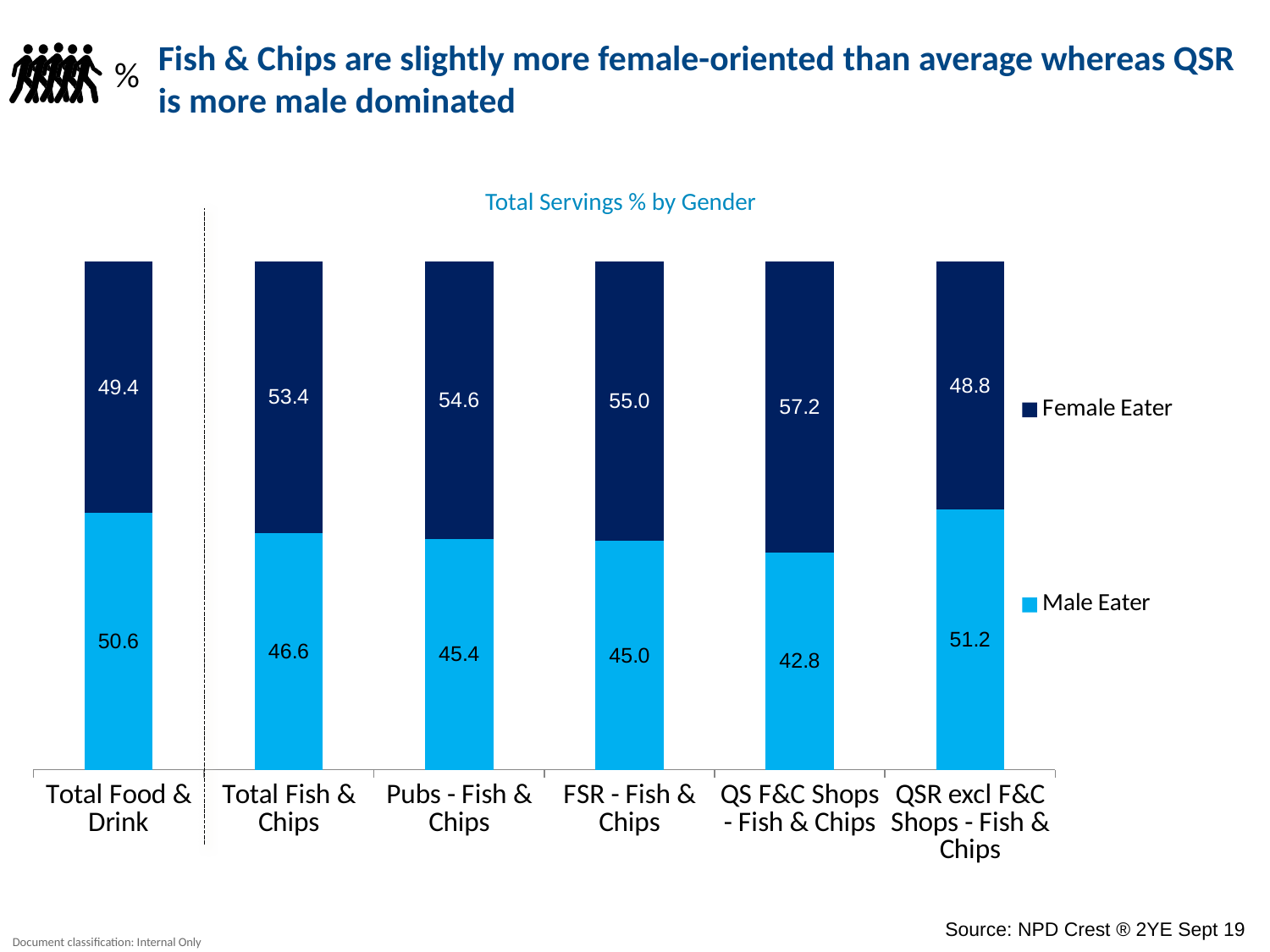
What is the Male Eater value for QSR excl F&C Shops - Fish & Chips? 51.2 What is the Female Eater value for QS F&C Shops - Fish & Chips? 57.2 Which category has the lowest Male Eater value? QS F&C Shops - Fish & Chips What is the title of the chart? Total Servings % by Gender How many series does the legend list? 2 How many categories are shown on the x axis? 6 Which is larger, the Male Eater value for FSR - Fish & Chips or for QSR excl F&C Shops - Fish & Chips? QSR excl F&C Shops - Fish & Chips Which category has the highest Female Eater value? QS F&C Shops - Fish & Chips What is the Male Eater value for Total Food & Drink? 50.6 What is the Female Eater value for Pubs - Fish & Chips? 54.6 What kind of chart is shown? Stacked bar chart What is the difference between the Female Eater values for Total Fish & Chips and Total Food & Drink? 4.0